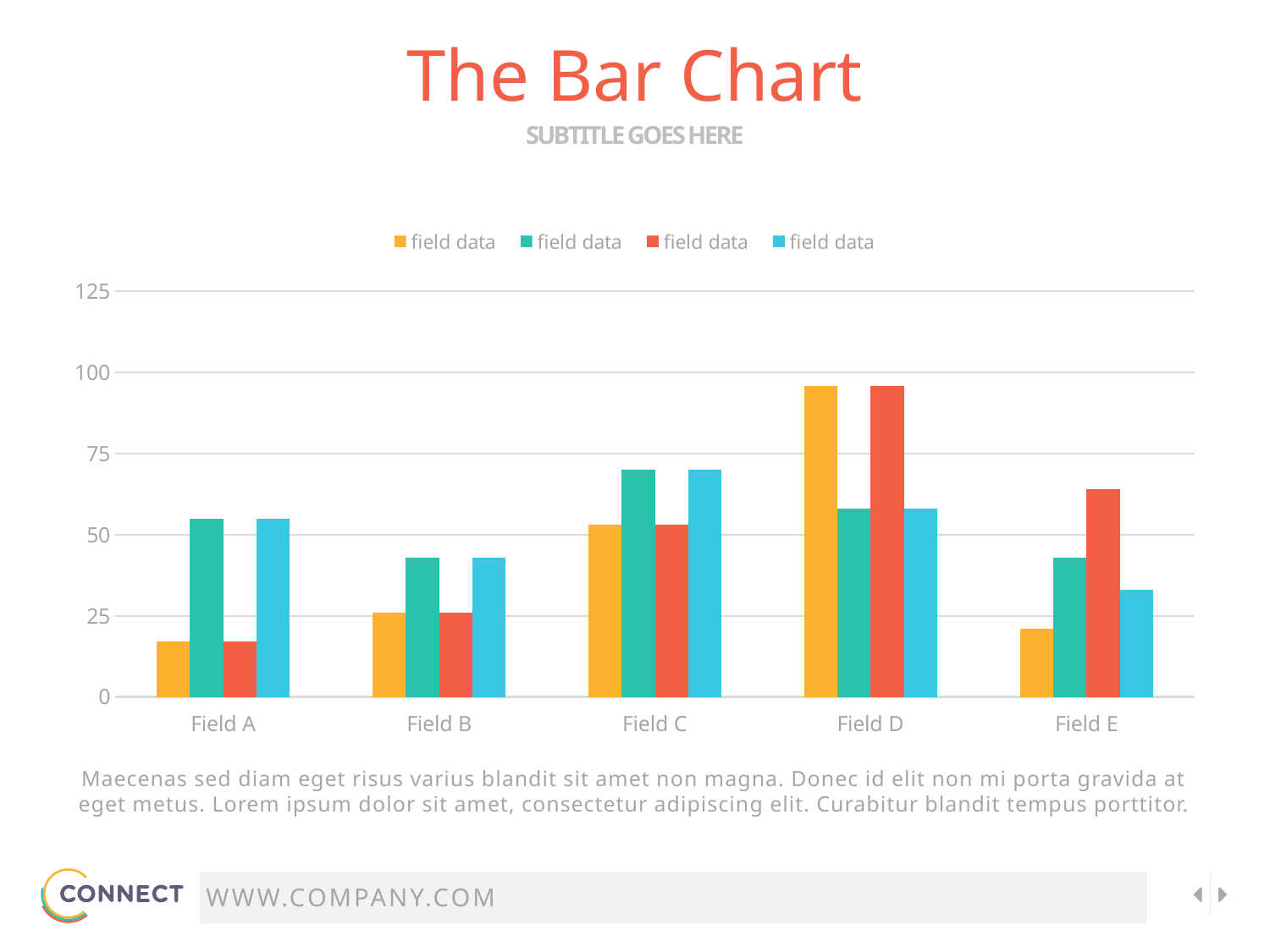
For the yellow series, which category has the highest value? Field D Is the value of the green bar for Field C greater or less than 50? greater How many series does the legend list? 4 Is the value of the red bar for Field E greater or less than 50? greater Is the value of the yellow bar for Field A greater or less than 25? less For the yellow series, which category has the lowest value? Field A What kind of chart is shown on the slide? bar chart How many categories are shown on the x axis? 5 Which is larger: the red bar for Field D or the red bar for Field E? Field D What is the title of the chart slide? The Bar Chart